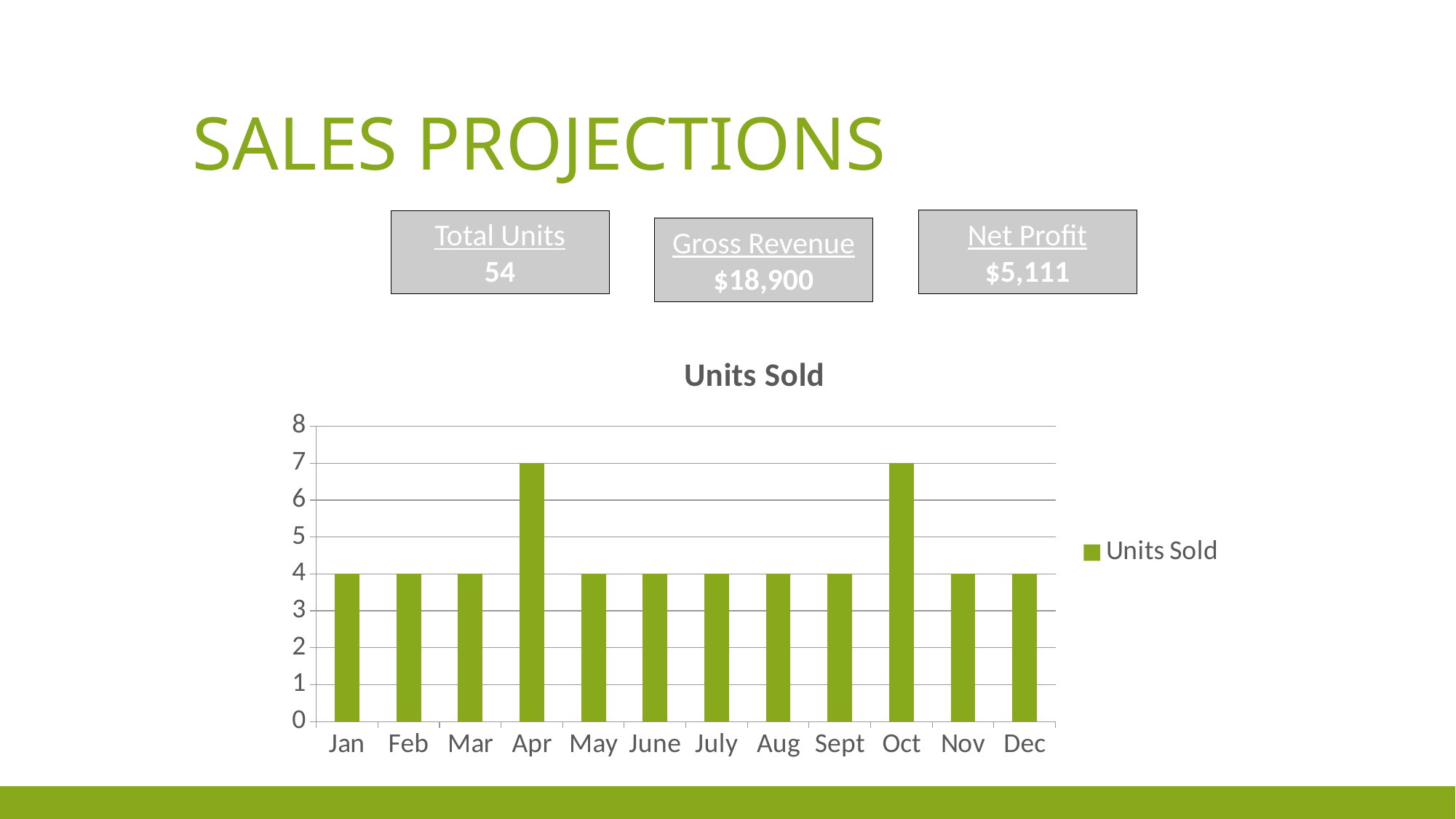
What is the value for Apr in the Units Sold chart? 7 How many series does the legend of the Units Sold chart list? 1 What is the title of the chart? Units Sold What is the value for Jan in the Units Sold chart? 4 What kind of chart is shown on the slide? Bar chart What is the value for Oct in the Units Sold chart? 7 How many months are shown on the x axis of the Units Sold chart? 12 Which months have the highest value in the Units Sold chart? Apr and Oct What is the name of the series shown in the legend of the chart? Units Sold What is the difference between the values for Oct and Sept in the Units Sold chart? 3 Is the value for Dec in the Units Sold chart greater or less than 6? less Which is larger in the Units Sold chart, the value for Apr or the value for May? Apr